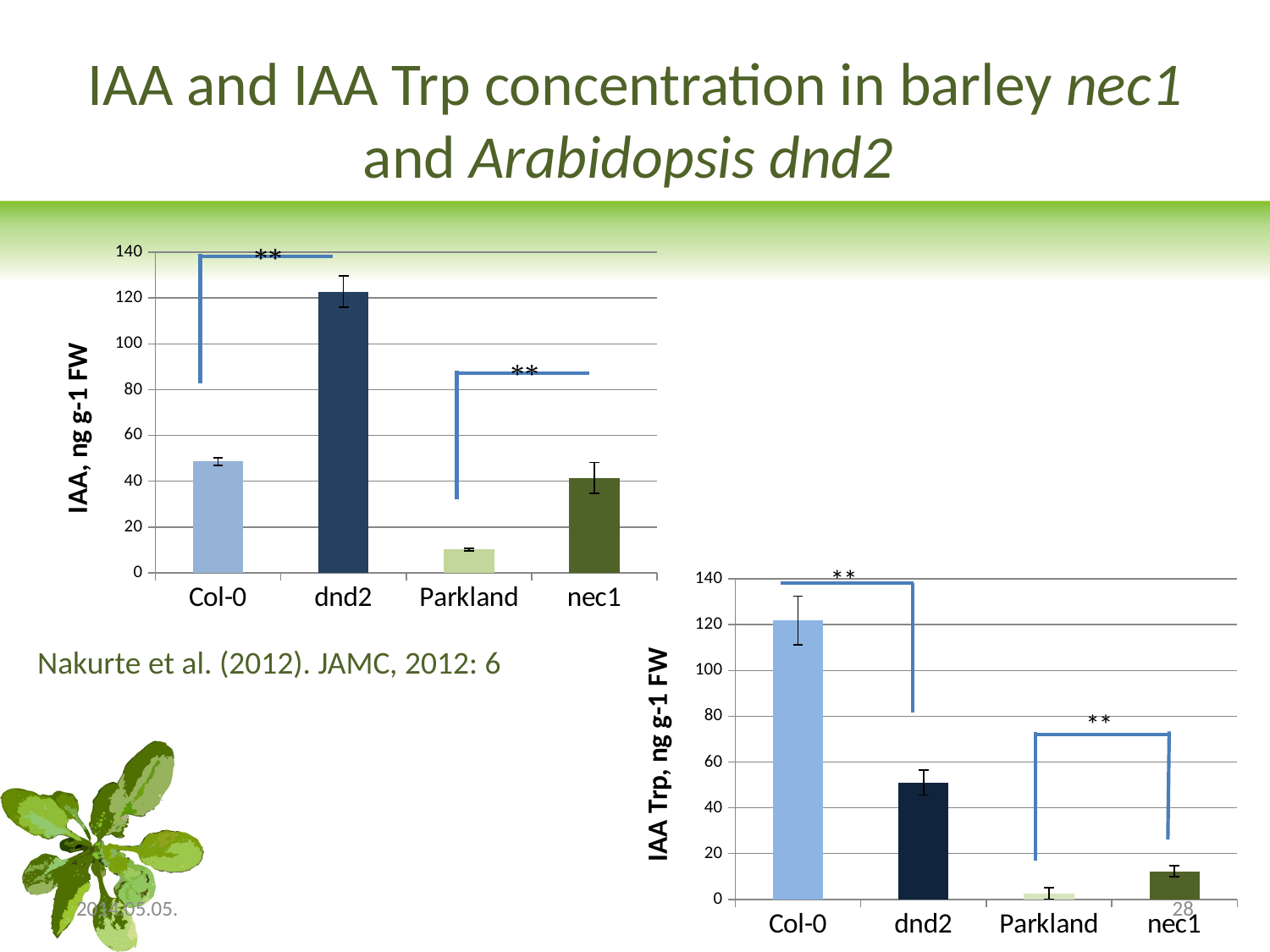
What is the y-axis label of the bottom-right chart? IAA Trp, ng g-1 FW How many categories are shown on the x axis of the top-left chart (IAA, ng g-1 FW)? 4 In the top-left chart (IAA, ng g-1 FW), is the value for Col-0 greater or less than 60? less In the bottom-right chart (IAA Trp, ng g-1 FW), is the value for dnd2 greater or less than 80? less In the bottom-right chart (IAA Trp, ng g-1 FW), which category has the lowest bar? Parkland In the bottom-right chart (IAA Trp, ng g-1 FW), which is larger, the value for dnd2 or the value for nec1? dnd2 In the top-left chart (IAA, ng g-1 FW), is the value for dnd2 greater or less than 100? greater In the top-left chart (IAA, ng g-1 FW), which category has the lowest bar? Parkland What kind of chart is the top-left chart with the y-axis labelled "IAA, ng g-1 FW"? bar chart In the top-left chart (IAA, ng g-1 FW), which category has the highest bar? dnd2 In the bottom-right chart (IAA Trp, ng g-1 FW), which category has the highest bar? Col-0 In the top-left chart (IAA, ng g-1 FW), which is larger, the value for Col-0 or the value for nec1? Col-0